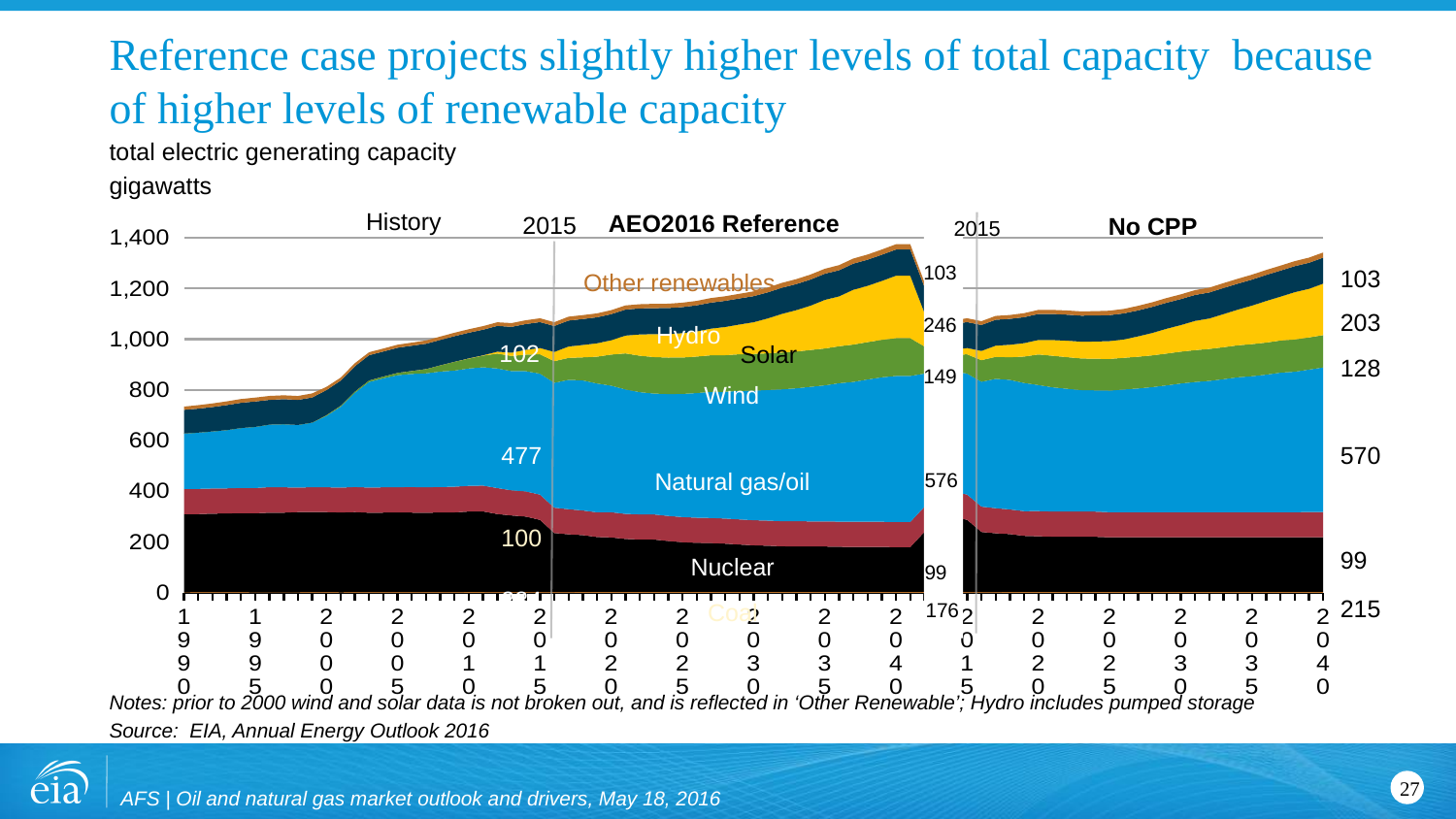
In the No CPP panel, what is the labeled value for Coal in 2040? 215 What is the difference between the 2040 Natural gas/oil values in the AEO2016 Reference panel (576) and the No CPP panel (570)? 6 In the AEO2016 Reference panel, what is the labeled value for Natural gas/oil in 2040? 576 In the AEO2016 Reference panel, is the total electric generating capacity in 2040 greater or less than 1,200 gigawatts? greater What kind of chart is shown on the slide? stacked area chart Which panel shows the larger Natural gas/oil value in 2040, AEO2016 Reference or No CPP? AEO2016 Reference How many fuel/technology series are labeled in the chart? 7 In the AEO2016 Reference panel, what is the labeled value for Nuclear in 2040? 99 In the AEO2016 Reference panel, what is the labeled value for Natural gas/oil in 2015? 477 In the History section, is the total electric generating capacity in 1990 greater or less than 800 gigawatts? less What is the difference between the 2040 Coal values in the No CPP panel (215) and the AEO2016 Reference panel (176)? 39 In the No CPP panel, what is the labeled value for Natural gas/oil in 2040? 570